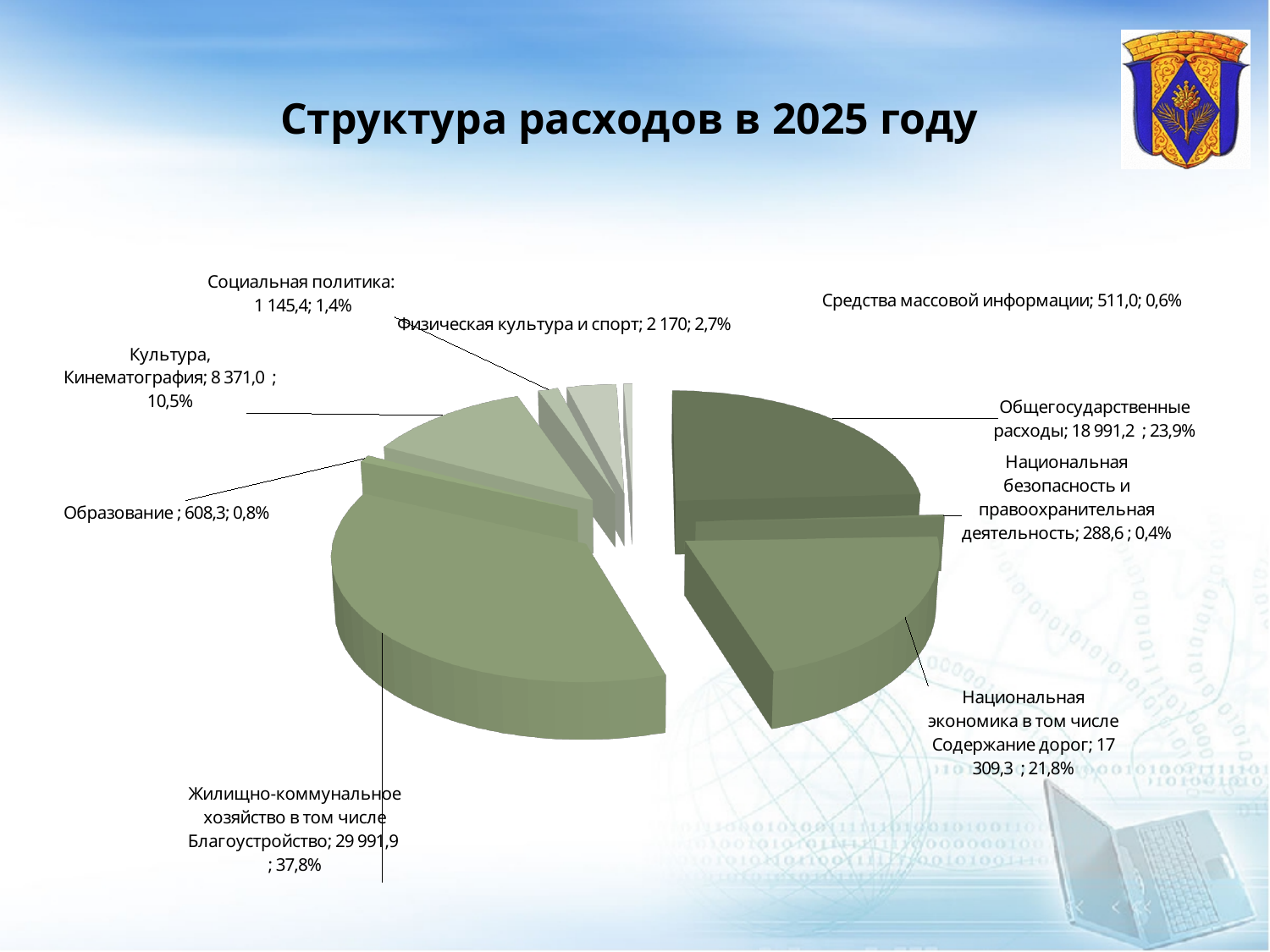
Which is larger, Общегосударственные расходы or Национальная экономика в том числе Содержание дорог? Общегосударственные расходы What value is shown for Общегосударственные расходы? 18 991,2 What is the title of the chart? Структура расходов в 2025 году What is the difference in percentage share between Общегосударственные расходы and Национальная экономика в том числе Содержание дорог? 2,1% What share of the pie does Культура, Кинематография have? 10,5% Which category has the smallest slice? Национальная безопасность и правоохранительная деятельность What value is shown for Средства массовой информации? 511,0 How many slices does the pie chart have? 9 What share of the pie does Жилищно-коммунальное хозяйство в том числе Благоустройство have? 37,8% Which category has the largest slice? Жилищно-коммунальное хозяйство в том числе Благоустройство What share of the pie does Образование have? 0,8% What kind of chart is shown on the slide? pie chart